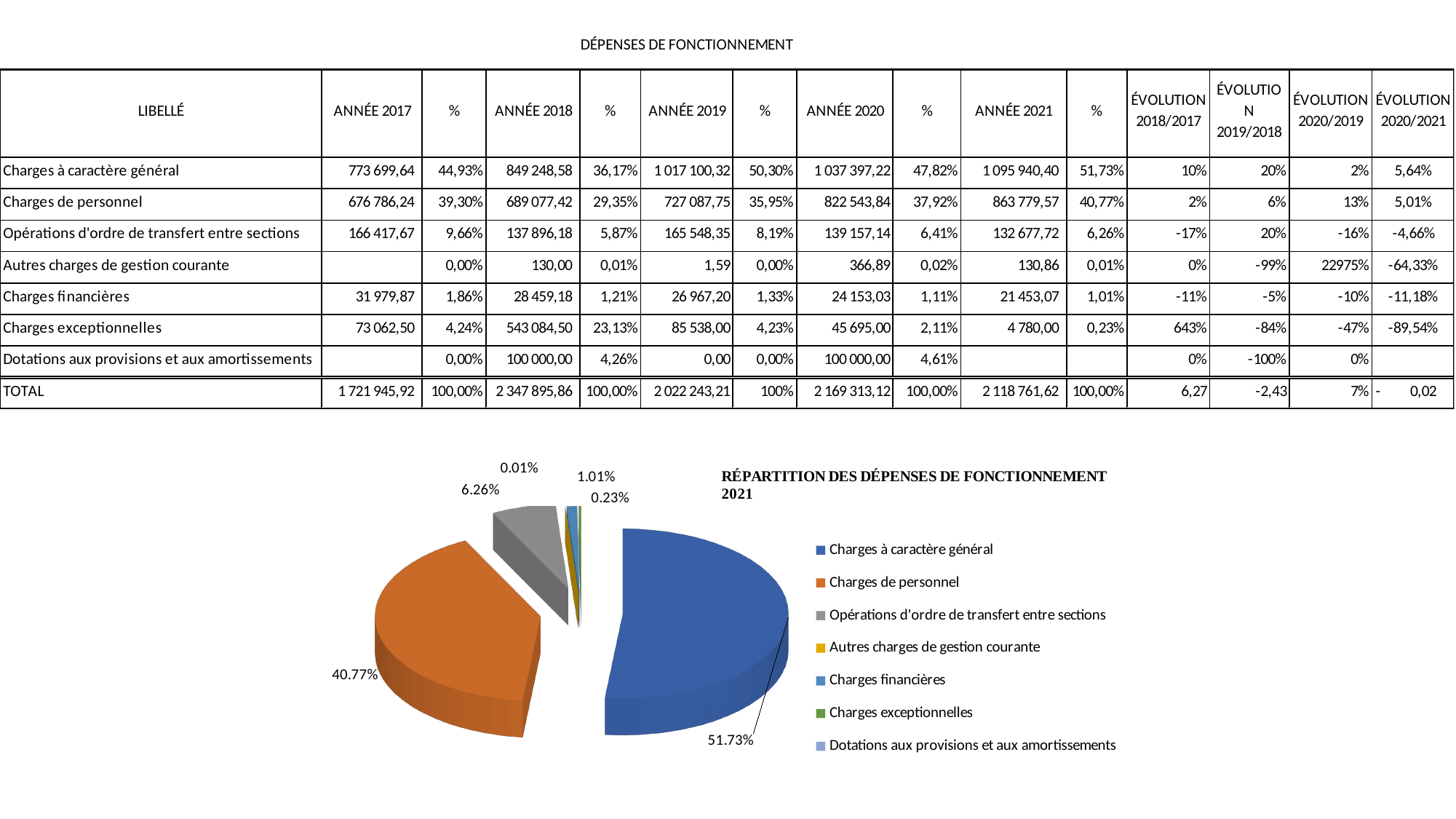
How many entries does the legend of the pie chart list? 7 In the pie chart, what share is shown for Charges exceptionnelles? 0.23% What is the title of the pie chart? RÉPARTITION DES DÉPENSES DE FONCTIONNEMENT 2021 In the pie chart, what share is shown for Charges à caractère général? 51.73% What is the difference between the shares of Charges à caractère général and Charges de personnel in the pie chart? 10.96% In the pie chart, what share is shown for Opérations d'ordre de transfert entre sections? 6.26% Which category has the largest slice in the pie chart? Charges à caractère général What colour is the Charges de personnel slice in the pie chart? Orange What kind of chart is shown on the slide? Pie chart Which of the two is larger in the pie chart: Charges de personnel or Opérations d'ordre de transfert entre sections? Charges de personnel